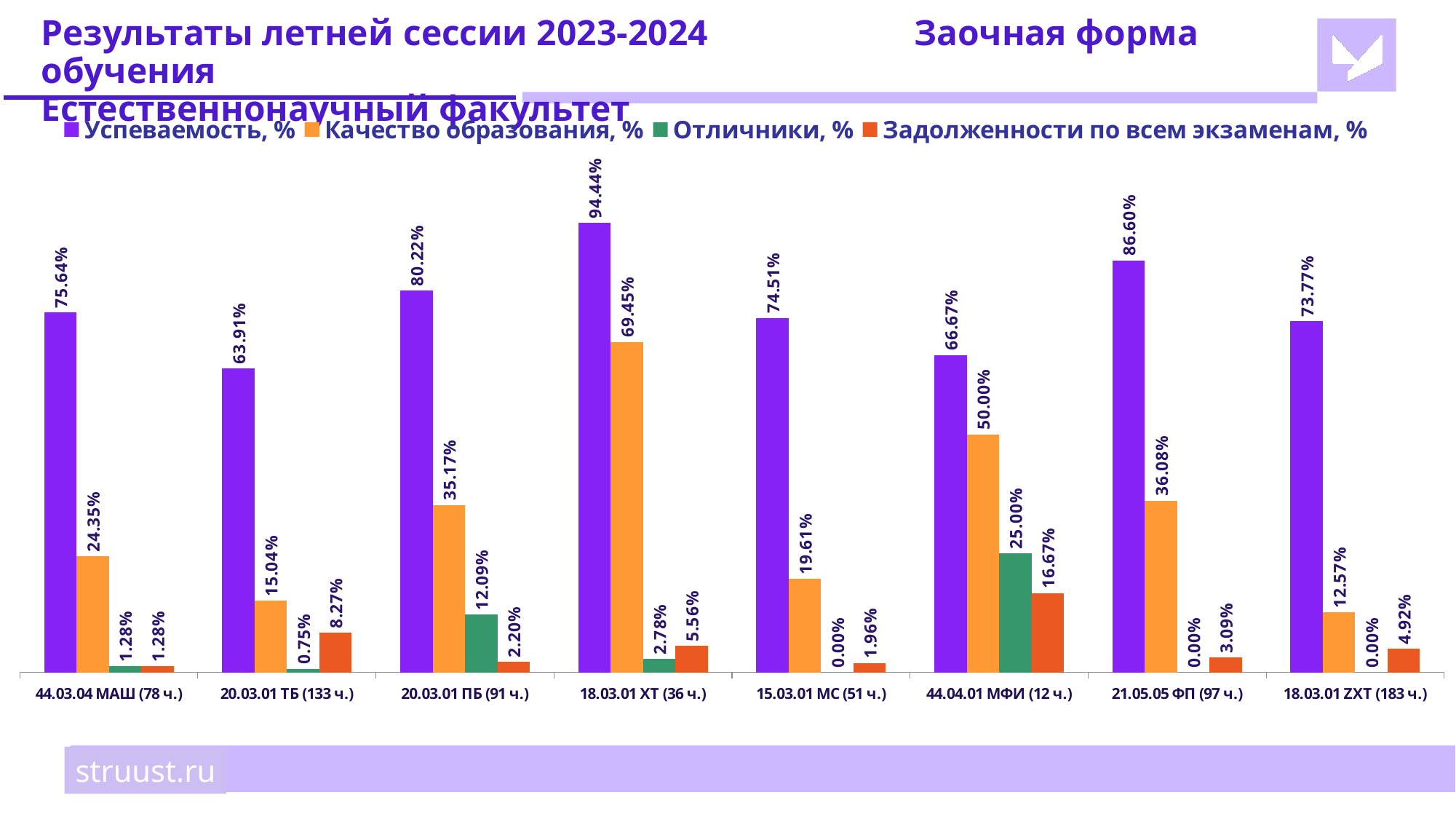
What is the Задолженности по всем экзаменам, % value for 20.03.01 ТБ (133 ч.)? 8.27% Which category has the highest Успеваемость, % value? 18.03.01 ХТ (36 ч.) Which is larger: the Качество образования, % value for 21.05.05 ФП (97 ч.) or for 20.03.01 ПБ (91 ч.)? 21.05.05 ФП (97 ч.) Which category has the highest Отличники, % value? 44.04.01 МФИ (12 ч.) What is the Качество образования, % value for 44.04.01 МФИ (12 ч.)? 50.00% Which category has the lowest Успеваемость, % value? 20.03.01 ТБ (133 ч.) What is the difference between the Успеваемость, % values for 18.03.01 ХТ (36 ч.) and 20.03.01 ТБ (133 ч.)? 30.53% How many categories are shown on the x axis of the chart? 8 What kind of chart is shown on the slide? Bar chart What is the Отличники, % value for 20.03.01 ПБ (91 ч.)? 12.09% What is the Успеваемость, % value for 18.03.01 ХТ (36 ч.)? 94.44% How many series does the legend list? 4